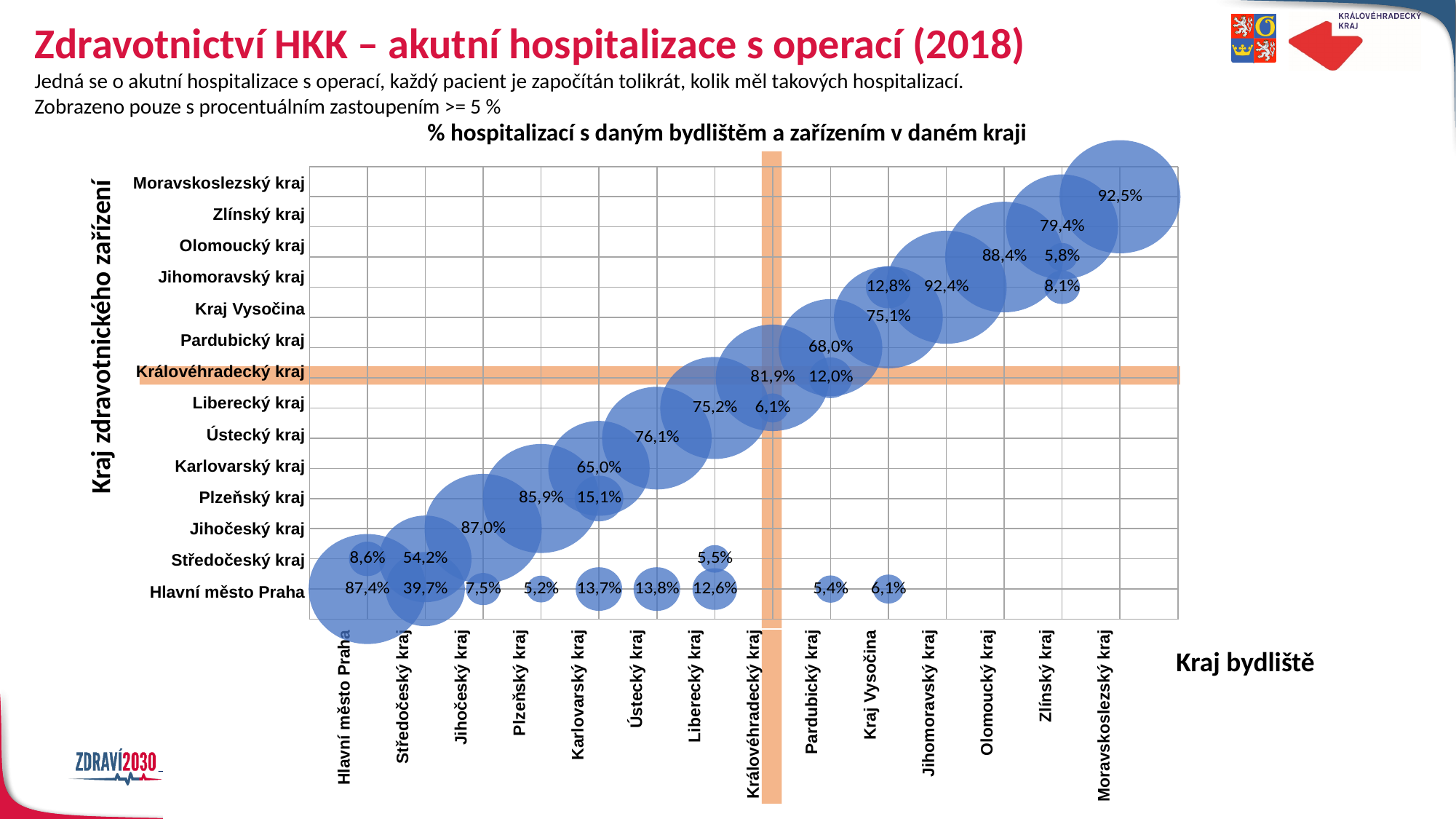
What percentage is shown for patients living in Středočeský kraj who were hospitalized in a facility in Hlavní město Praha? 39,7% What is the difference between the percentage for Hlavní město Praha residents hospitalized in Hlavní město Praha (87,4%) and Středočeský kraj residents hospitalized in Hlavní město Praha (39,7%)? 47,7% What kind of chart is shown on the slide? bubble chart Which is the smallest percentage value labelled on the chart? 5,2% What percentage is shown for patients living in Pardubický kraj who were hospitalized in a facility in Královéhradecký kraj? 12,0% What is the chart's title? % hospitalizací s daným bydlištěm a zařízením v daném kraji What percentage is shown for patients living in Královéhradecký kraj who were hospitalized in a facility in Královéhradecký kraj? 81,9% What is the label of the horizontal axis? Kraj bydliště How many regions (kraje) are listed along the horizontal axis? 14 What percentage is shown for patients living in Hlavní město Praha who were hospitalized in a facility in Hlavní město Praha? 87,4% Which is larger: the percentage for Středočeský kraj residents hospitalized in Středočeský kraj, or the percentage for Karlovarský kraj residents hospitalized in Karlovarský kraj? Karlovarský kraj (65,0%) What percentage is shown for patients living in Moravskoslezský kraj who were hospitalized in a facility in Moravskoslezský kraj? 92,5%